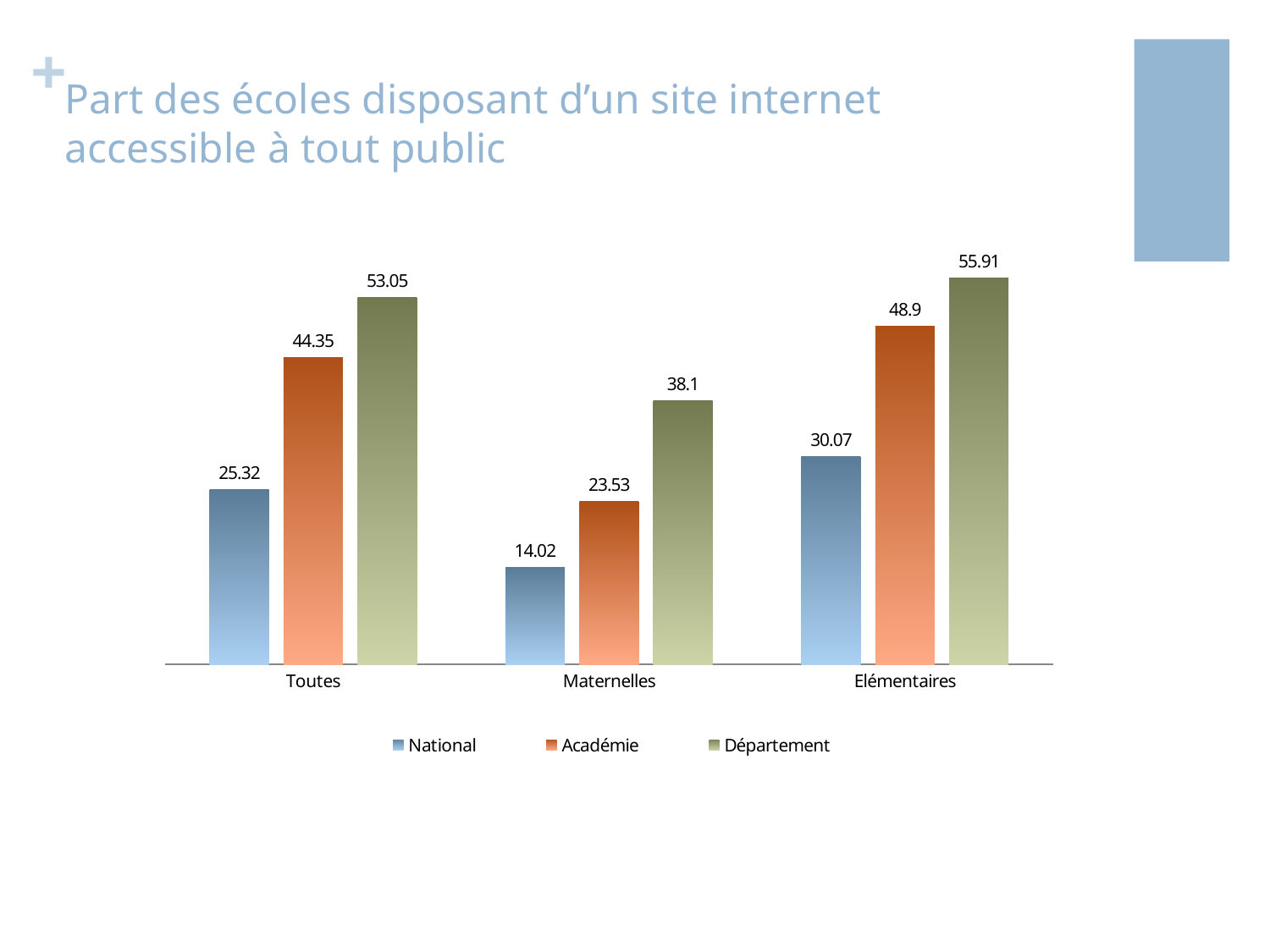
Which series is shown in orange in the legend? Académie What is the difference between the Département and National values in the Toutes category? 27.73 What is the value for Académie in the Elémentaires category? 48.9 What kind of chart is shown on the slide? Bar chart How many categories are shown on the x axis? 3 How many series does the legend list? 3 Which category has the highest Département value? Elémentaires What is the difference between the Académie values for Elémentaires and Maternelles? 25.37 What is the value for National in the Toutes category? 25.32 What is the value for Département in the Maternelles category? 38.1 Which is larger in the Maternelles category: Académie or National? Académie Which category has the lowest National value? Maternelles